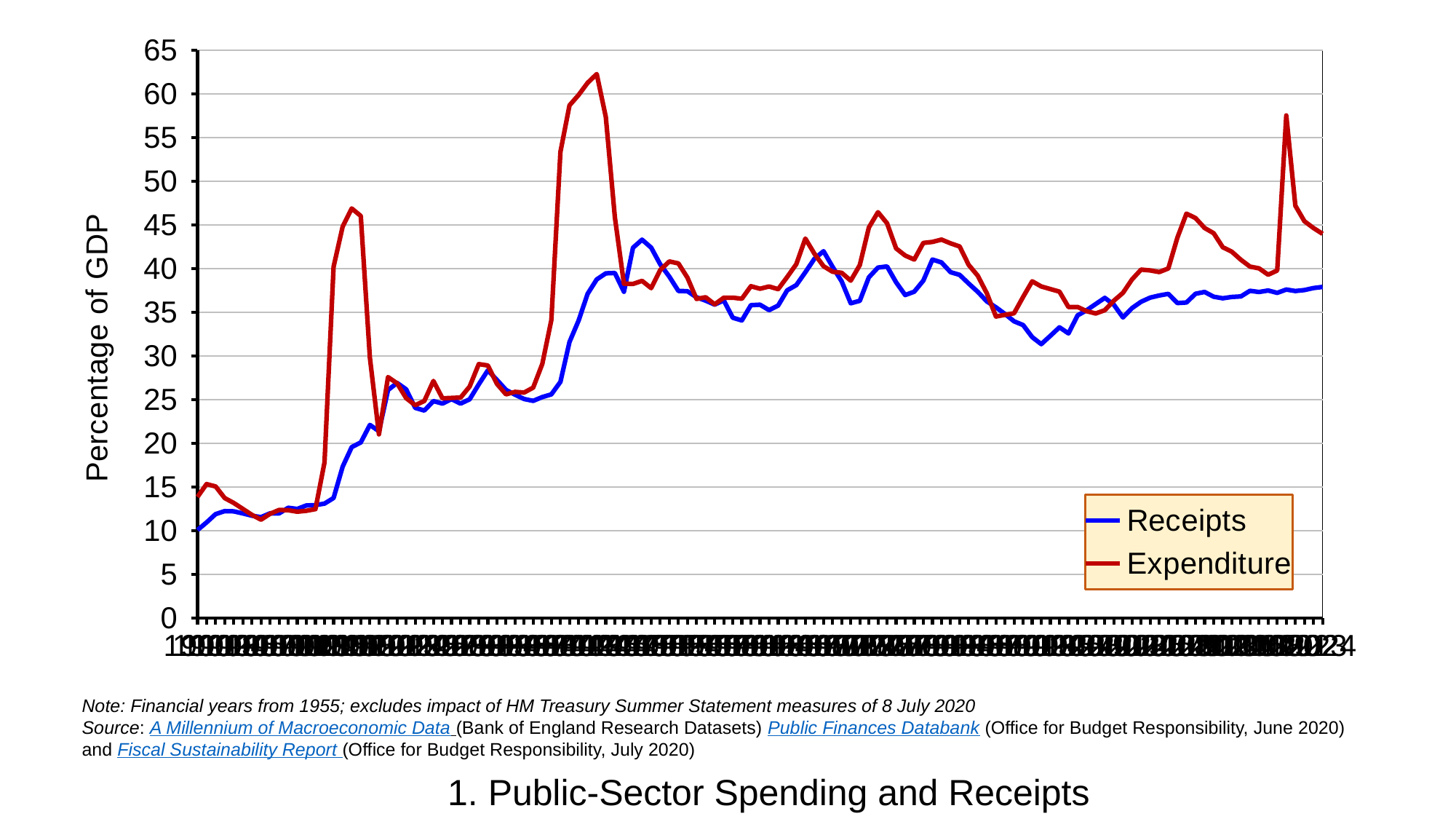
What is the title of the chart? 1. Public-Sector Spending and Receipts Is the value of the Expenditure line at the far right end of the chart greater or less than 40? greater Is the highest value of the Receipts line greater or less than 45? less What is the label on the vertical axis? Percentage of GDP What is the highest value shown on the vertical axis? 65 What kind of chart is shown on the slide? Line chart Which series reaches the highest peak on the chart, Receipts or Expenditure? Expenditure Is the lowest value of the Receipts line greater or less than 15? less Do the Receipts values generally rise or fall from the left of the chart to the right? rise How many series does the legend list? 2 At the far right end of the chart, which line is higher, Receipts or Expenditure? Expenditure